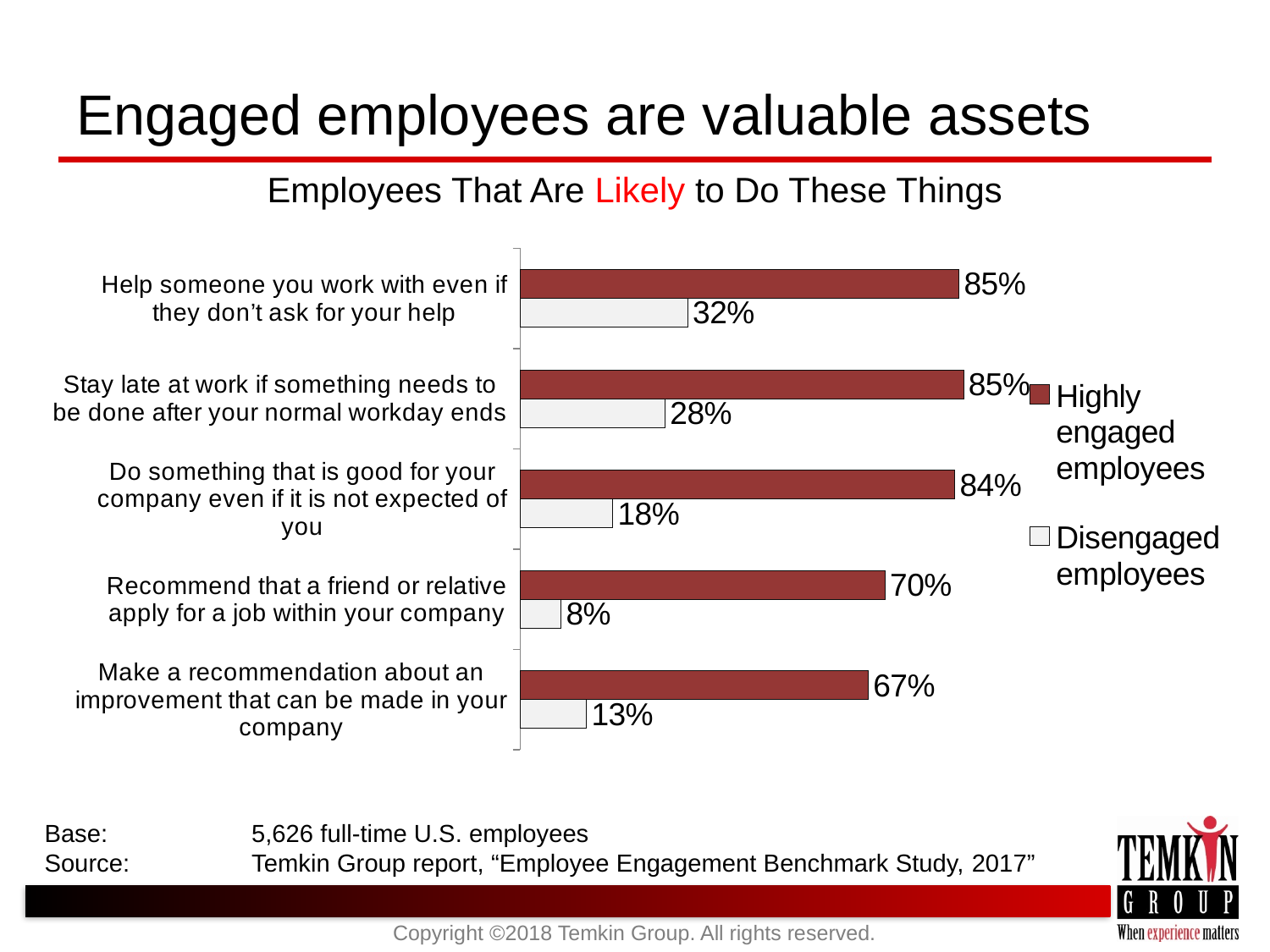
What percentage of disengaged employees are likely to make a recommendation about an improvement that can be made in their company? 13% What percentage of highly engaged employees are likely to do something that is good for their company even if it is not expected of them? 84% What is the title of the chart? Employees That Are Likely to Do These Things Which is larger: the disengaged employees value for 'Do something that is good for your company' or for 'Make a recommendation about an improvement'? Do something that is good for your company What percentage of highly engaged employees are likely to help someone they work with even if they don't ask for help? 85% Which item has the highest value for disengaged employees? Help someone you work with even if they don't ask for your help How many items (categories) are shown in the chart? 5 How many series does the legend list? 2 What kind of chart is shown on the slide? Bar chart Which item has the lowest value for highly engaged employees? Make a recommendation about an improvement that can be made in your company What percentage of disengaged employees are likely to recommend that a friend or relative apply for a job within their company? 8% What is the difference between highly engaged and disengaged employees for 'Stay late at work if something needs to be done after your normal workday ends'? 57 percentage points